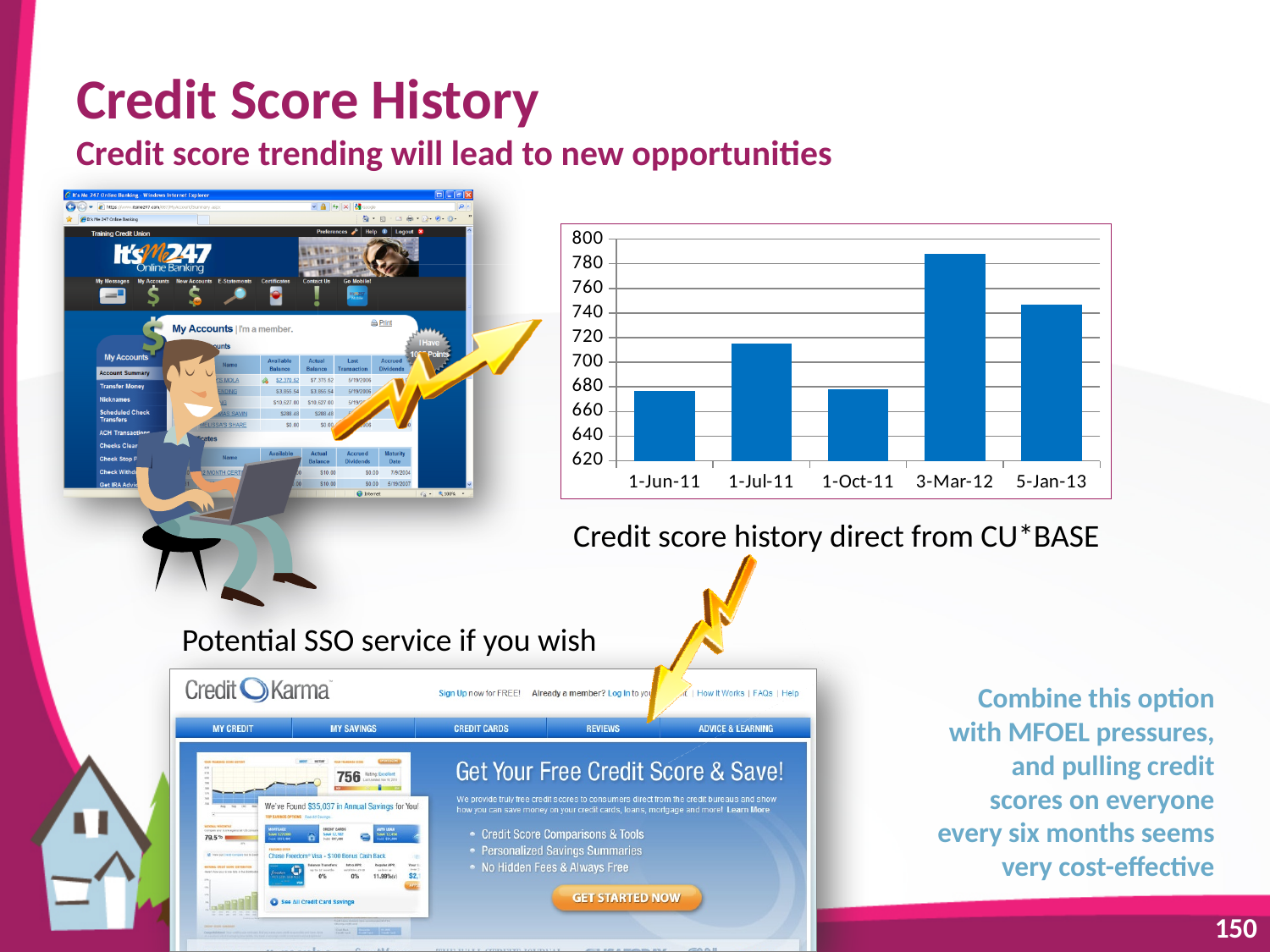
Does the value rise or fall from 1-Oct-11 to 3-Mar-12? rise Is the value for 5-Jan-13 greater or less than 740? greater Is the value for 3-Mar-12 greater or less than 780? greater Which is larger, the value for 1-Jul-11 or the value for 5-Jan-13? 5-Jan-13 Is the value for 1-Oct-11 greater or less than 700? less How many dates are shown on the x axis of the chart? 5 What is the highest value shown on the chart's vertical axis? 800 Which date has the highest bar in the chart? 3-Mar-12 Which is larger, the value for 3-Mar-12 or the value for 1-Jul-11? 3-Mar-12 What kind of chart is shown on the slide? bar chart